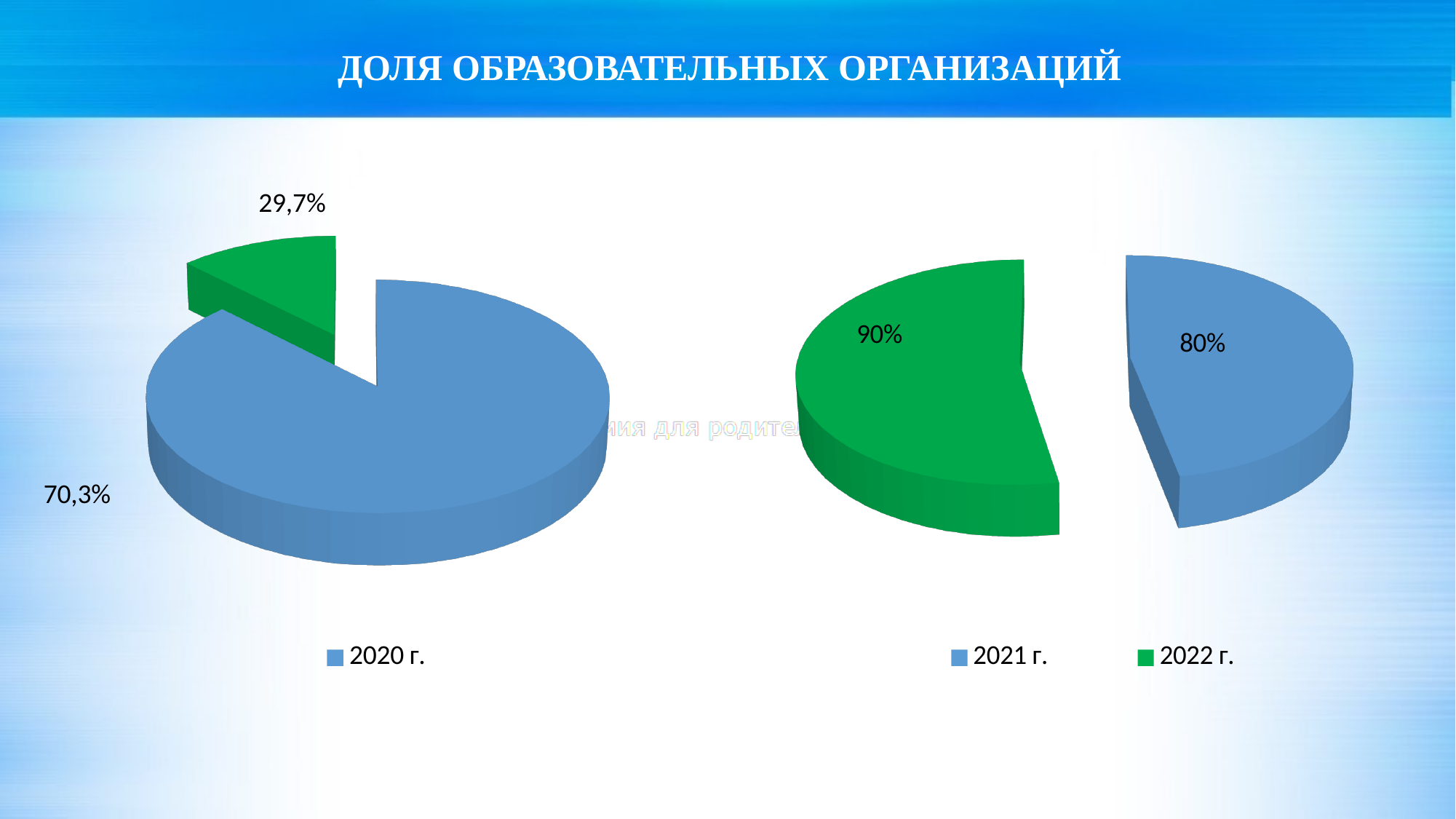
In the left pie chart, what is the difference between the blue slice (70,3%) and the green slice (29,7%)? 40,6% In the right pie chart, which year has the larger value, 2021 г. or 2022 г.? 2022 г. How many entries does the legend of the left pie chart list? 1 In the left pie chart, what value is printed on the large blue slice? 70,3% In the right pie chart, what value is printed for 2021 г.? 80% How many entries does the legend of the right pie chart list? 2 How many charts are shown on the slide? 2 In the right pie chart, what is the difference between the values for 2022 г. and 2021 г.? 10% What kind of chart is the chart on the left of the slide? pie chart In the right pie chart, what value is printed for 2022 г.? 90% In the left pie chart, what value is printed on the small green slice? 29,7% In the left pie chart, which slice is larger, the blue one or the green one? the blue one